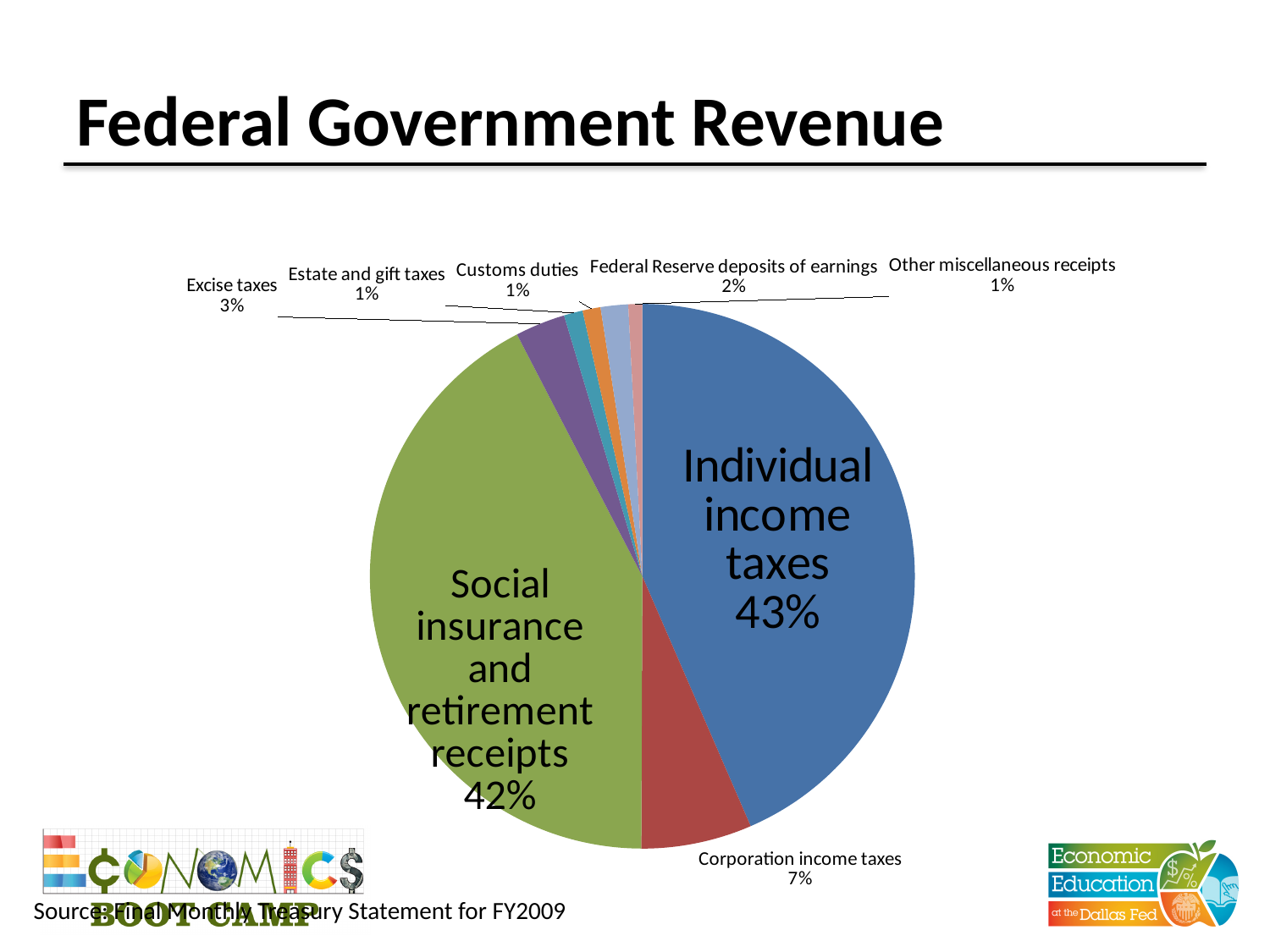
What share of federal government revenue comes from Individual income taxes? 43% What is the difference in percentage points between Individual income taxes and Corporation income taxes? 36 percentage points What is the title of the chart on the slide? Federal Government Revenue How many slices does the pie chart have? 8 What share of federal government revenue comes from Social insurance and retirement receipts? 42% What percentage of revenue is from Customs duties? 1% What percentage of revenue is from Federal Reserve deposits of earnings? 2% What percentage of revenue is from Corporation income taxes? 7% What percentage of revenue is from Excise taxes? 3% Which revenue source has the largest share of the pie? Individual income taxes What kind of chart is shown on the slide? Pie chart Which is larger: the share for Individual income taxes or the share for Social insurance and retirement receipts? Individual income taxes